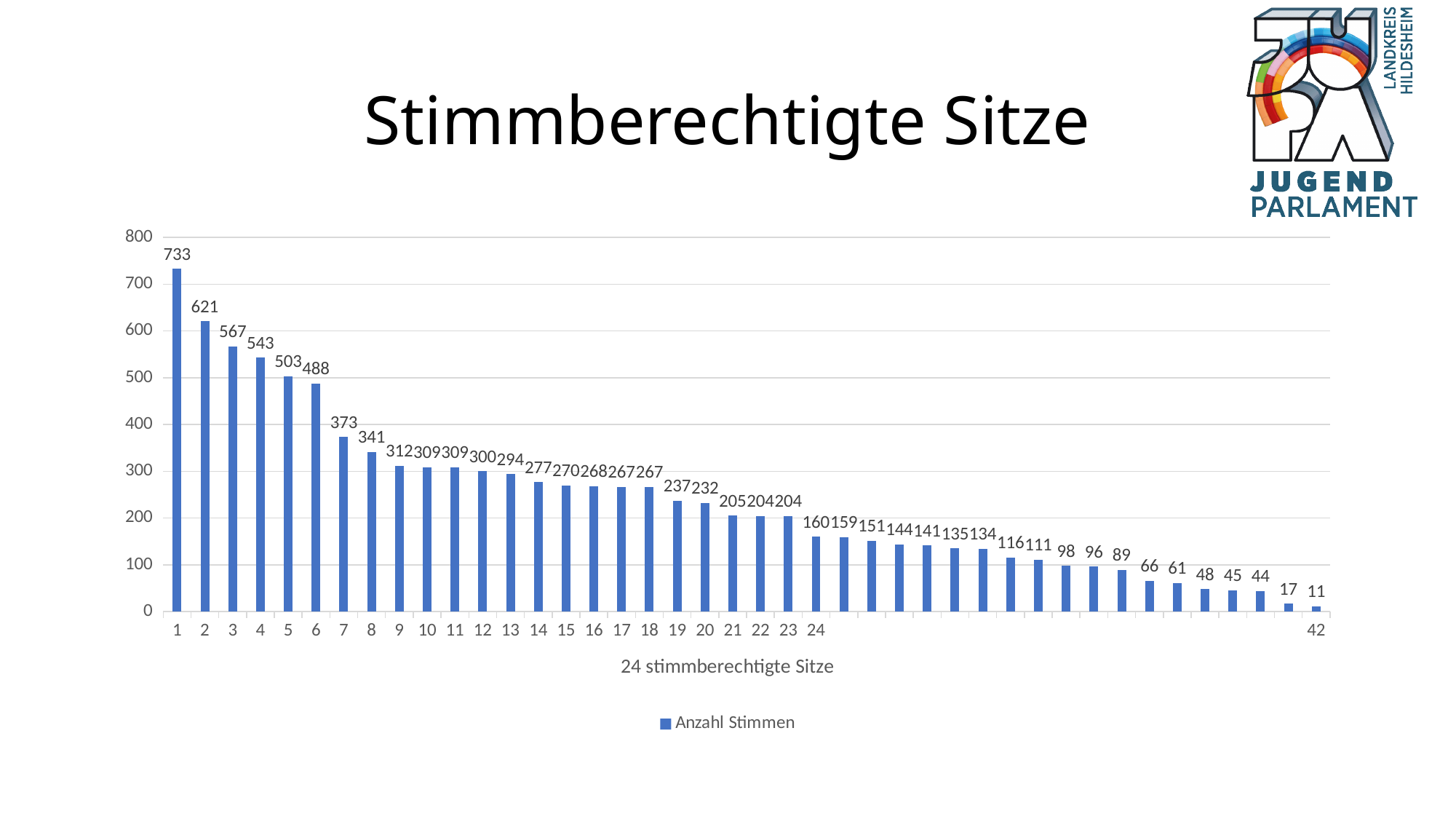
What kind of chart is shown on the slide? bar chart What is the value for category 42? 11 What is the value for category 24? 160 How many series does the legend list? 1 How many bars are plotted in the chart? 42 What is the value for category 1? 733 Do the values rise or fall from left to right along the x axis? fall Which category has the lowest value? 42 Which category has the highest value? 1 Which is larger, the value for category 3 or category 4? category 3 What is the value for category 7? 373 What is the difference between the values for category 1 and category 2? 112